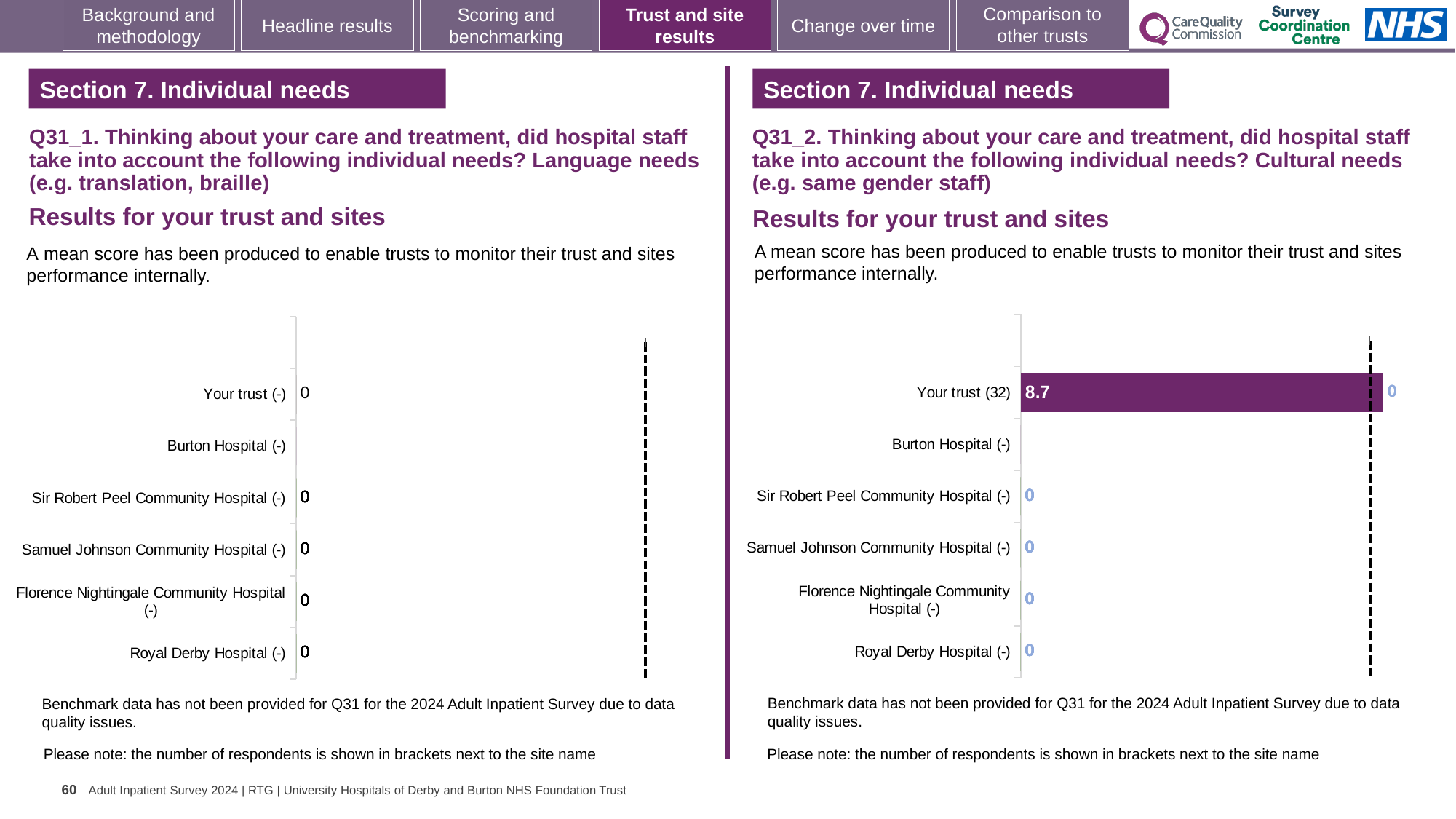
On the right-hand chart (Q31_2, Cultural needs), which category has the highest value? Your trust (32) On the right-hand chart (Q31_2, Cultural needs), how many respondents are shown in brackets for Your trust? 32 How many categories are listed on the right-hand chart (Q31_2, Cultural needs)? 6 On the right-hand chart (Q31_2, Cultural needs), what value is labelled for Royal Derby Hospital? 0 On the right-hand chart (Q31_2, Cultural needs), is the value for Your trust greater or less than 5? greater On the right-hand chart (Q31_2, Cultural needs), which is larger: the value for Your trust or the value for Sir Robert Peel Community Hospital? Your trust What type of chart is used on the right-hand side of the slide (Q31_2, Cultural needs)? Bar chart According to the note below the charts, why has benchmark data not been provided for Q31? Due to data quality issues How many categories are listed on the left-hand chart (Q31_1, Language needs)? 6 On the left-hand chart (Q31_1, Language needs), what value is labelled for Your trust? 0 On the right-hand chart (Q31_2, Cultural needs), what is the mean score shown for Your trust? 8.7 On the right-hand chart (Q31_2, Cultural needs), what is the difference between the value for Your trust and the value for Samuel Johnson Community Hospital? 8.7